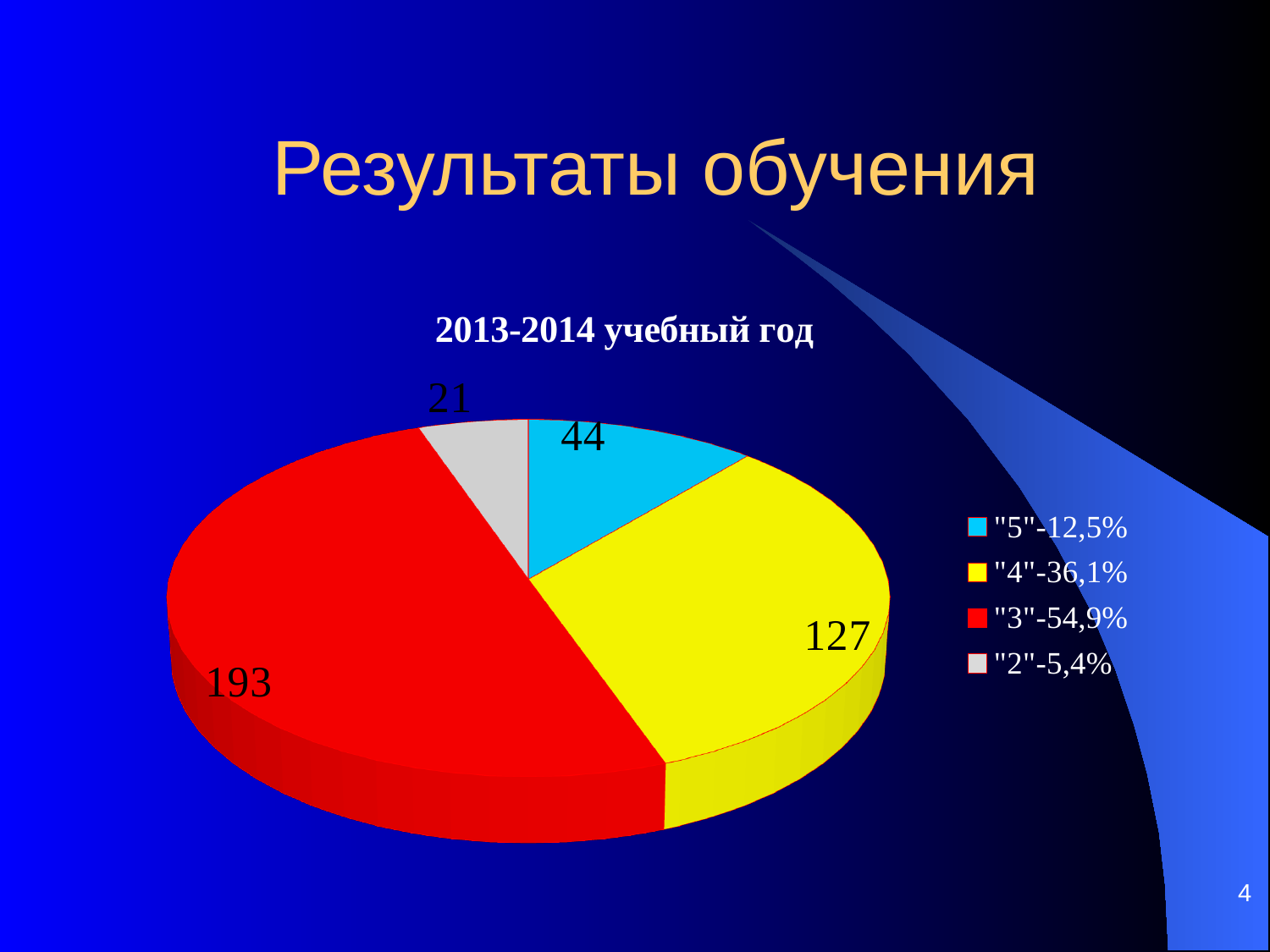
What is the difference between the values for "3" and "4"? 66 Which grade has the smallest slice of the pie? "2" Which grade has the largest slice of the pie? "3" What value is shown for the "3" slice? 193 What share of the pie does the "4" slice represent, according to the legend? 36,1% What value is shown for the "4" slice? 127 How many entries does the legend list? 4 What value is shown for the "5" slice? 44 What is the title of the chart? 2013-2014 учебный год How many slices does the pie chart have? 4 What value is shown for the "2" slice? 21 What type of chart is shown on the slide? pie chart